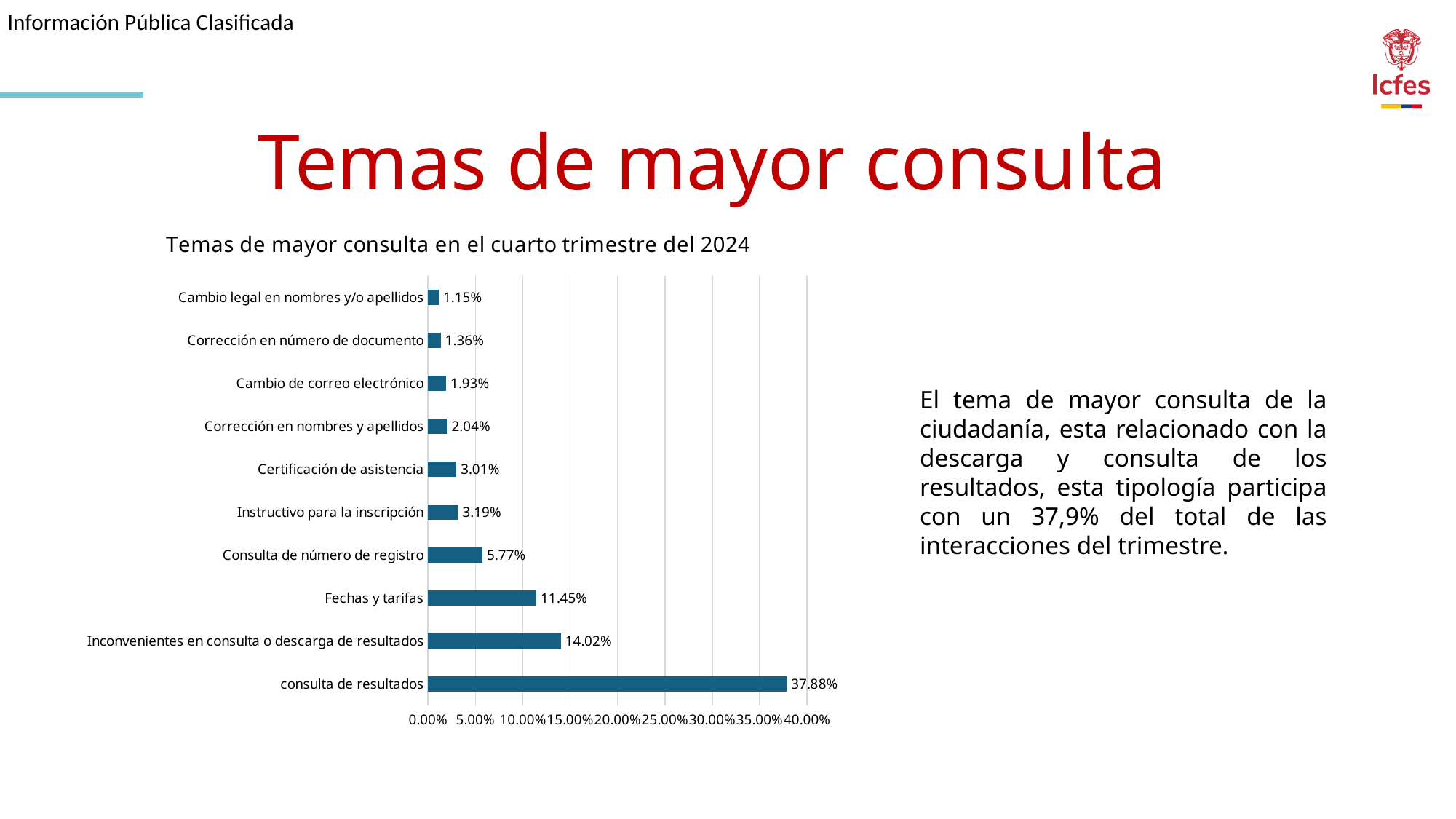
What is the value for 'Certificación de asistencia'? 3.01% What kind of chart is shown on the slide? bar chart Which category has the highest value? consulta de resultados What is the title of the chart? Temas de mayor consulta en el cuarto trimestre del 2024 What is the difference between 'Inconvenientes en consulta o descarga de resultados' and 'Fechas y tarifas'? 2.57% What is the value for 'Inconvenientes en consulta o descarga de resultados'? 14.02% What is the value for 'consulta de resultados'? 37.88% Is the value for 'consulta de resultados' greater or less than 35.00%? greater Which is larger: 'Consulta de número de registro' or 'Instructivo para la inscripción'? Consulta de número de registro How many categories are shown in the chart? 10 Which category has the lowest value? Cambio legal en nombres y/o apellidos What is the value for 'Fechas y tarifas'? 11.45%